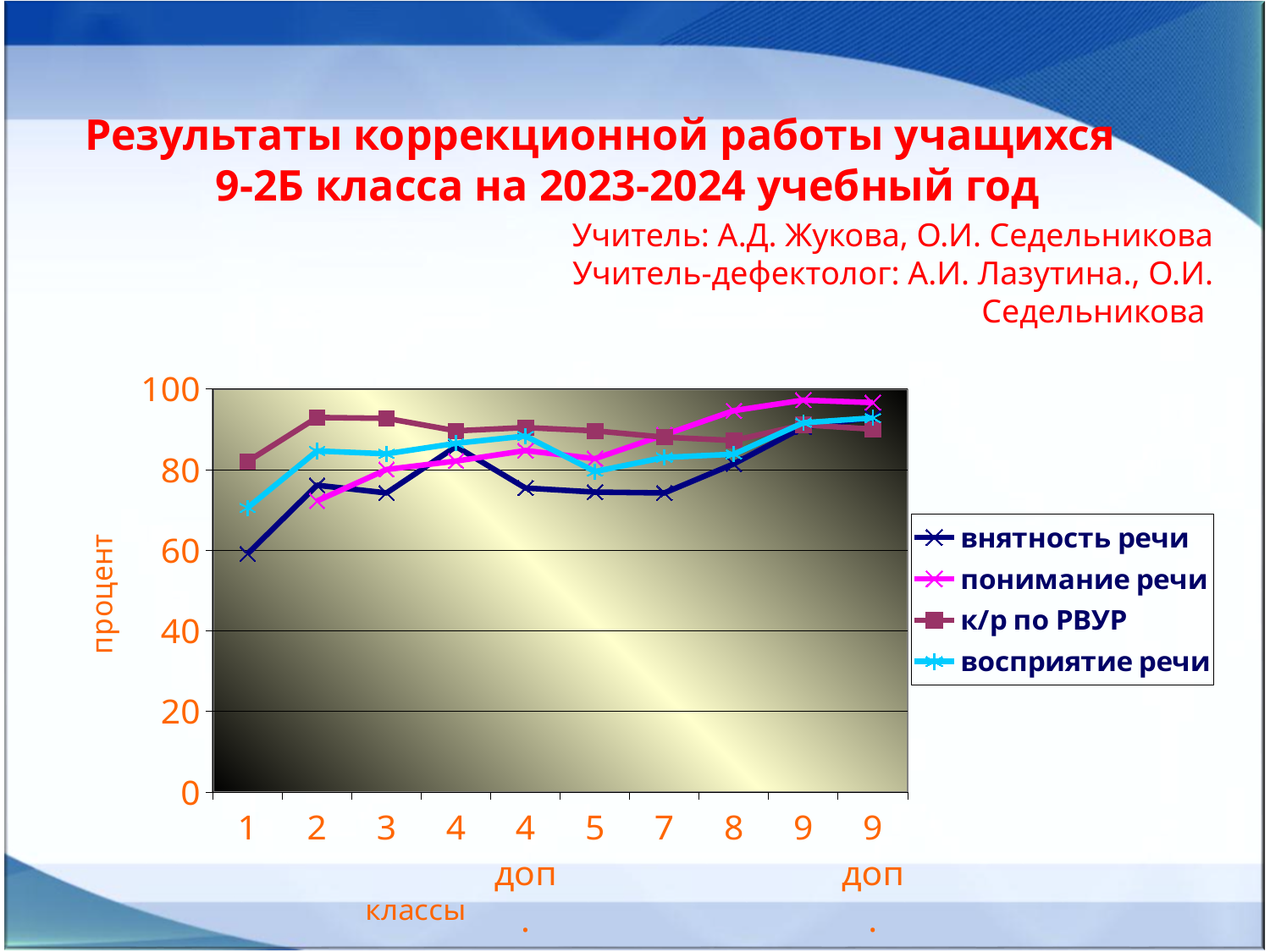
What is the first entry in the legend? внятность речи What kind of chart is shown on the slide? line chart How many series does the legend list? 4 Does the внятность речи line rise or fall from class 1 to class 2? rise Is the value of восприятие речи at class 1 greater or less than 60? greater At class 1, which series has the higher value: к/р по РВУР or внятность речи? к/р по РВУР At which x-axis category does внятность речи reach its lowest value? 1 Is the value of понимание речи at class 9 greater or less than 80? greater Is the value of внятность речи at class 1 greater or less than 80? less What is the title of the vertical axis? процент